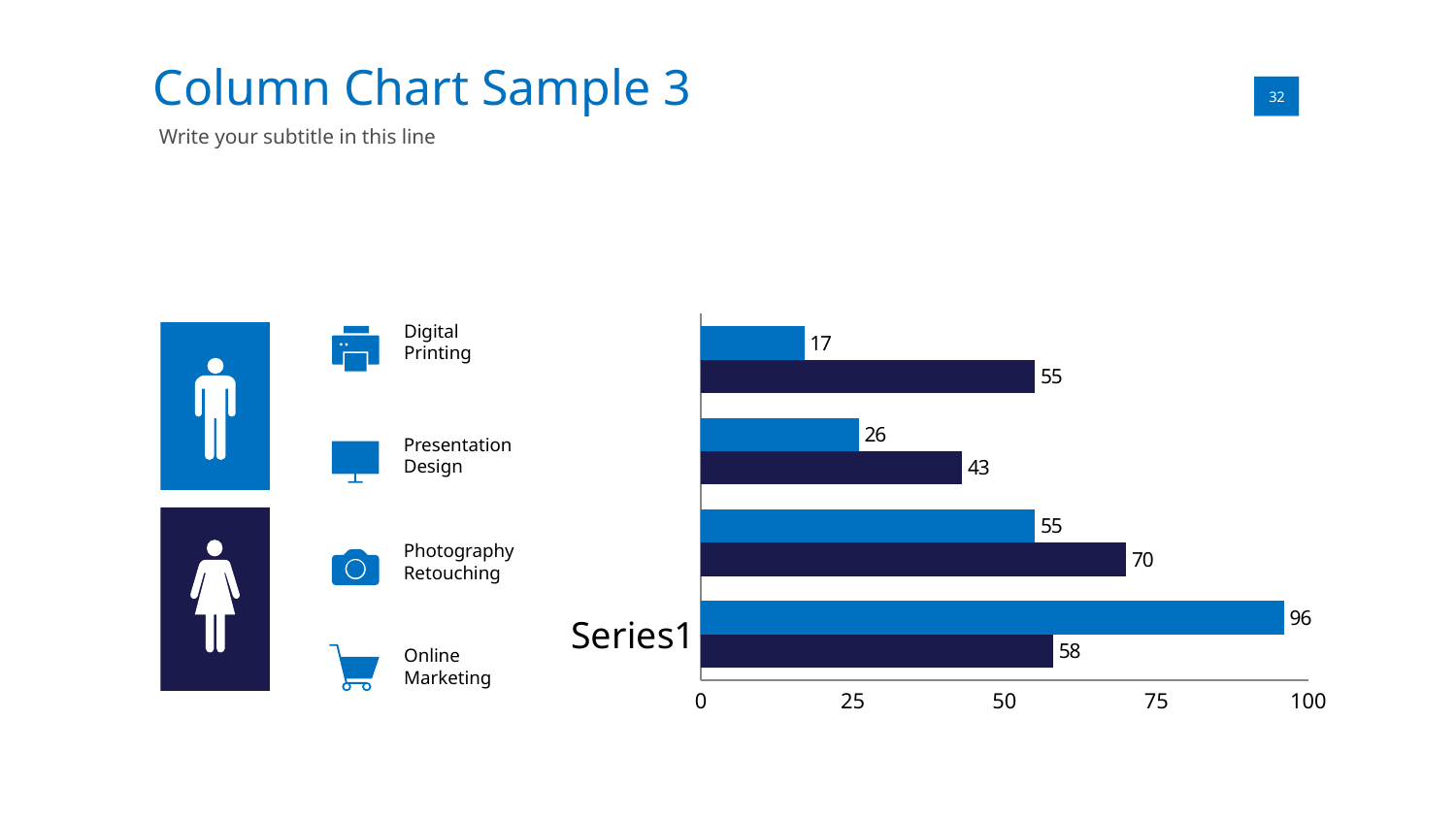
In the group labeled Series1, what is the value of the dark navy bar? 58 What kind of chart is shown on the slide? bar chart What is the value of the light blue bar in the topmost group of the chart? 17 Which bar has the highest value on the chart? The light blue bar in the Series1 group (96) Which bar has the lowest value on the chart? The light blue bar in the topmost group (17) How many groups of bars are plotted on the chart? 4 In the third group from the top, what is the difference between the dark navy bar (70) and the light blue bar (55)? 15 What is the highest tick value shown on the horizontal axis? 100 In the second group from the top, which bar is larger, the light blue bar or the dark navy bar? the dark navy bar What is the value of the dark navy bar in the second group from the top? 43 In the group labeled Series1, what is the difference between the light blue bar and the dark navy bar? 38 In the group labeled Series1, what is the value of the light blue bar? 96